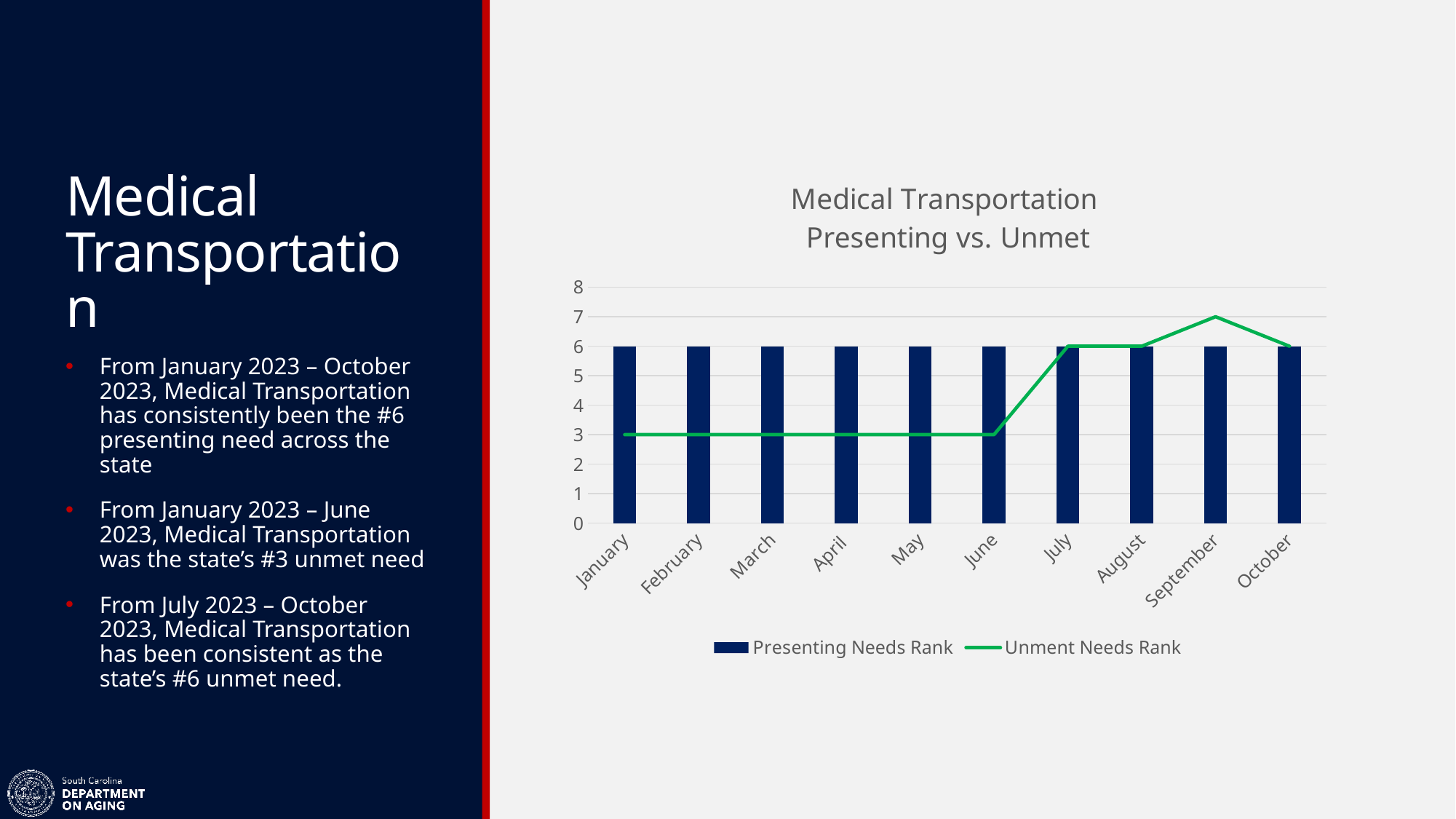
In which month is the Unment Needs Rank highest? September What is the difference between the Presenting Needs Rank and the Unment Needs Rank in February? 3 Does the Unment Needs Rank rise or fall between June and July? Rise How many months are shown on the x axis of the chart? 10 What is the Presenting Needs Rank for January? 6 How many series does the chart legend list? 2 What is the title of the chart? Medical Transportation Presenting vs. Unmet Which is larger in September, the Presenting Needs Rank or the Unment Needs Rank? Unment Needs Rank What is the Unment Needs Rank for September? 7 What type of chart is shown on the slide? A combined bar and line chart What is the Unment Needs Rank for October? 6 What is the Unment Needs Rank for March? 3